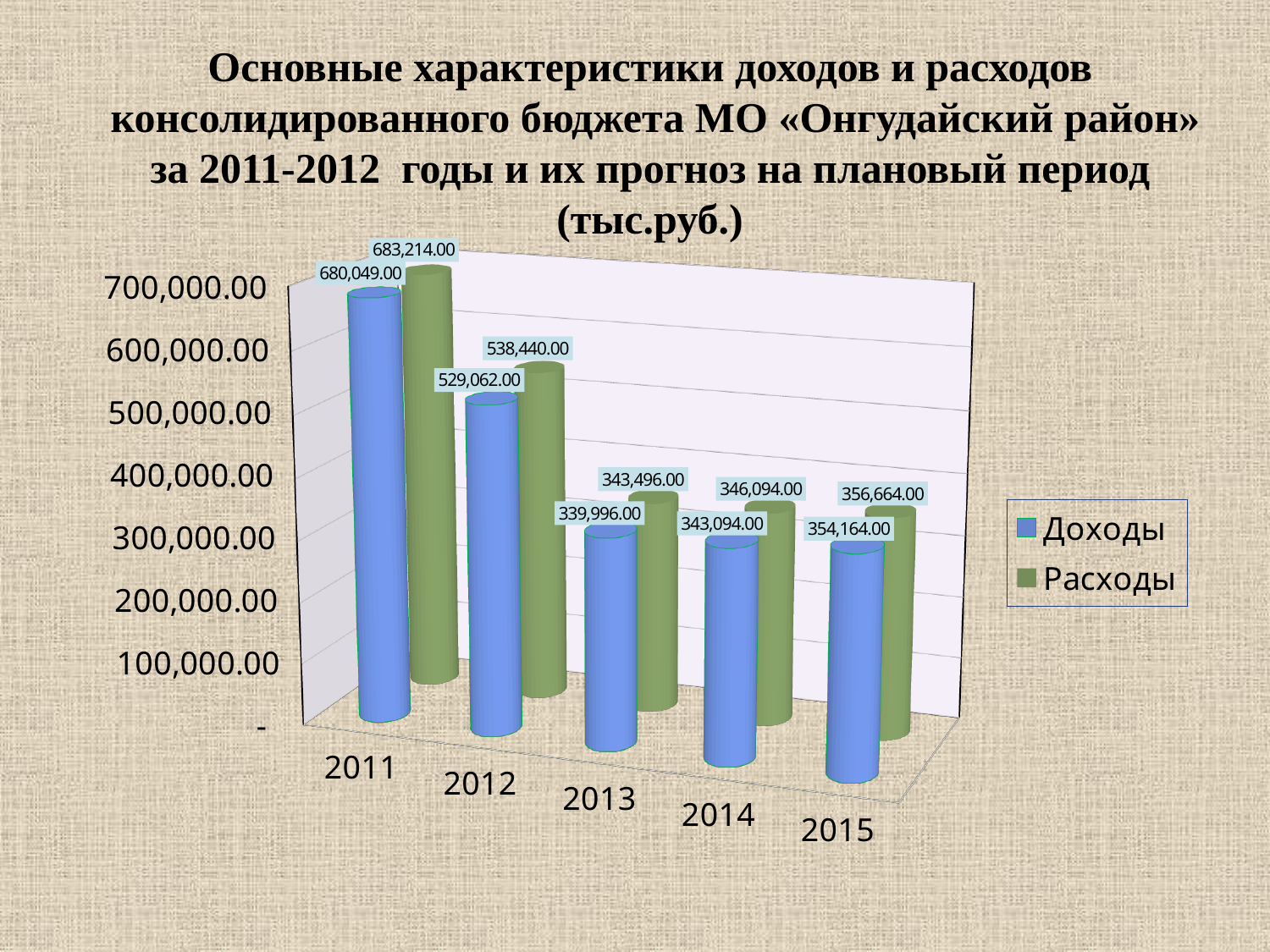
What is the value of Доходы for 2011? 680,049.00 How many years are shown on the x axis? 5 What is the value of Расходы for 2015? 356,664.00 What kind of chart is shown on the slide? Bar chart What is the value of Расходы for 2012? 538,440.00 What is the difference between Расходы and Доходы in 2014? 3,000.00 What is the difference between Доходы in 2011 and Доходы in 2012? 150,987.00 Which is larger in 2012: Доходы or Расходы? Расходы How many series does the legend list? 2 What is the value of Доходы for 2013? 339,996.00 Which year has the lowest value of Доходы? 2013 Which year has the highest value of Расходы? 2011